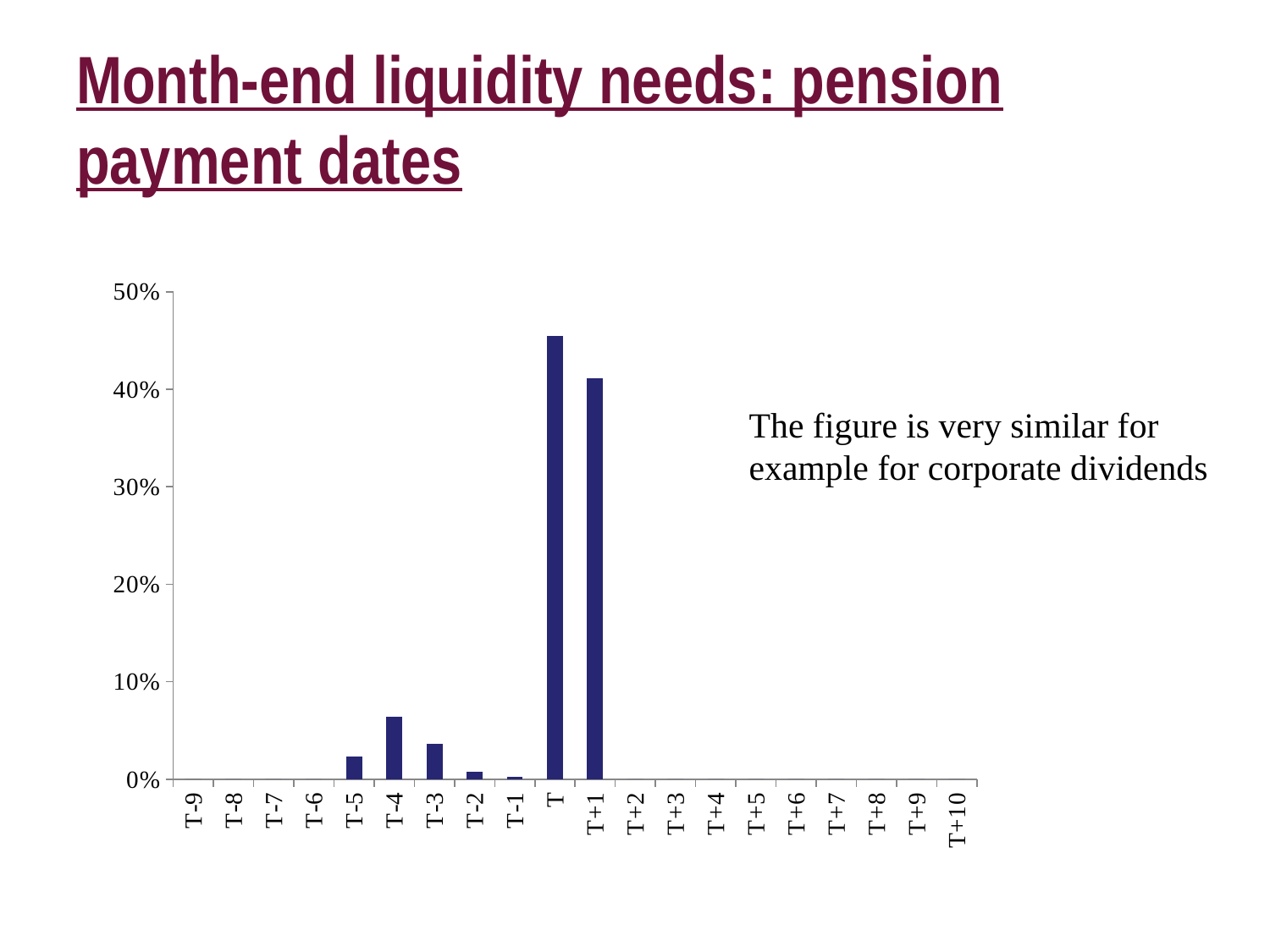
Which category has the highest bar in the chart? T Is the value for T-4 greater or less than 10%? less Is the value for T greater or less than 50%? less Is the value for T greater or less than 40%? greater What is the highest tick label shown on the y axis of the chart? 50% Which is larger, the value for T-5 or the value for T-2? T-5 What is the title of the slide containing the chart? Month-end liquidity needs: pension payment dates Which is larger, the value for T-4 or the value for T-3? T-4 Which is larger, the value for T or the value for T+1? T What kind of chart is shown on the slide? bar chart How many categories are shown on the x axis of the chart? 20